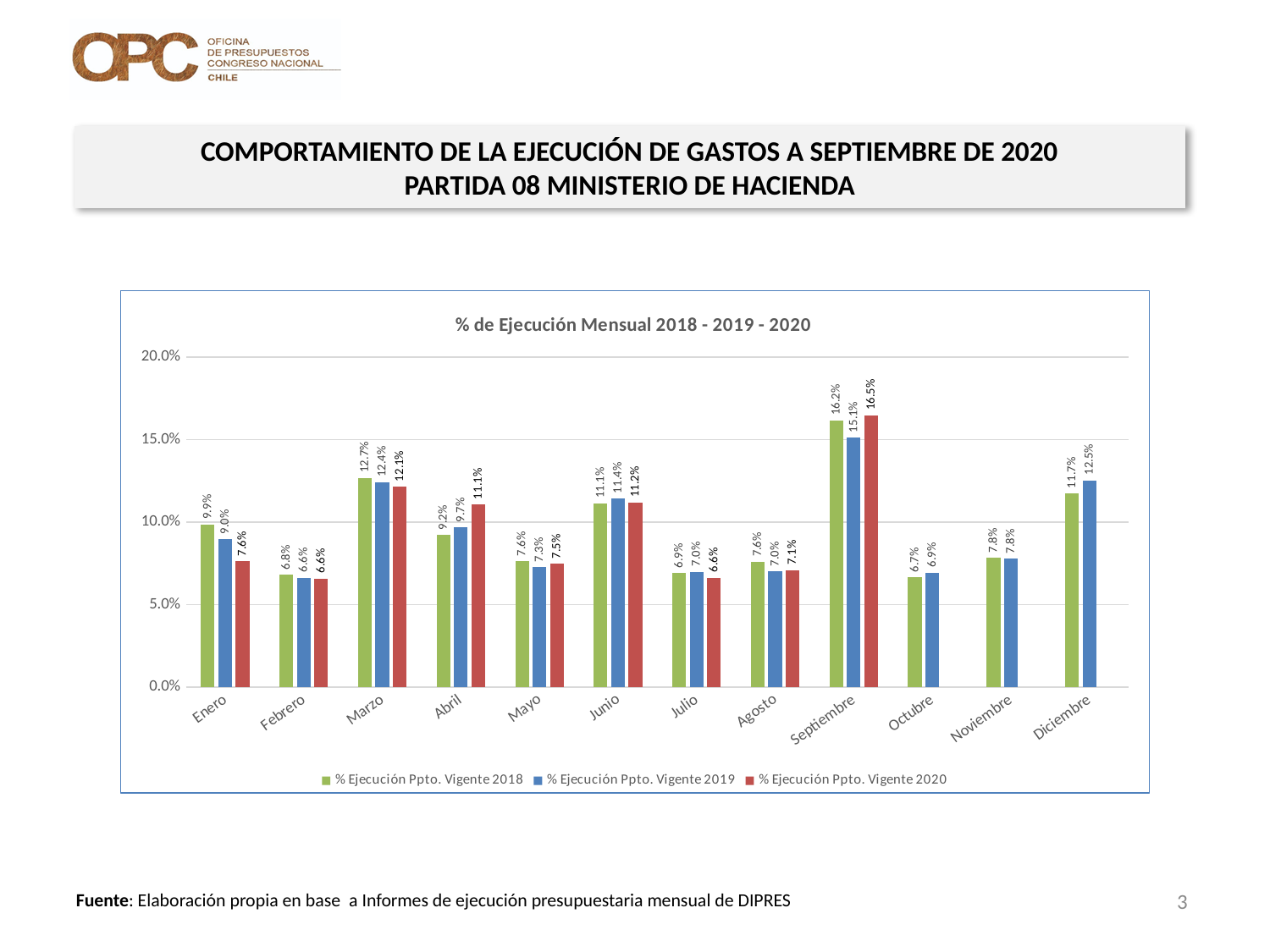
What is the title of the chart? % de Ejecución Mensual 2018 - 2019 - 2020 Which month has the lowest value in the % Ejecución Ppto. Vigente 2018 series? Octubre Which is larger for Abril: the 2018 value or the 2020 value? 2020 value What kind of chart is shown on the slide? Bar chart Is the value for Septiembre in the 2019 series greater or less than 15.0%? greater What is the value for Septiembre in the % Ejecución Ppto. Vigente 2020 series? 16.5% How many months are shown on the x axis? 12 How many series does the legend list? 3 What is the value for Marzo in the % Ejecución Ppto. Vigente 2018 series? 12.7% Which month has the highest value in the % Ejecución Ppto. Vigente 2020 series? Septiembre What is the difference between the 2018 and 2020 values for Enero? 2.3% What is the value for Diciembre in the % Ejecución Ppto. Vigente 2019 series? 12.5%